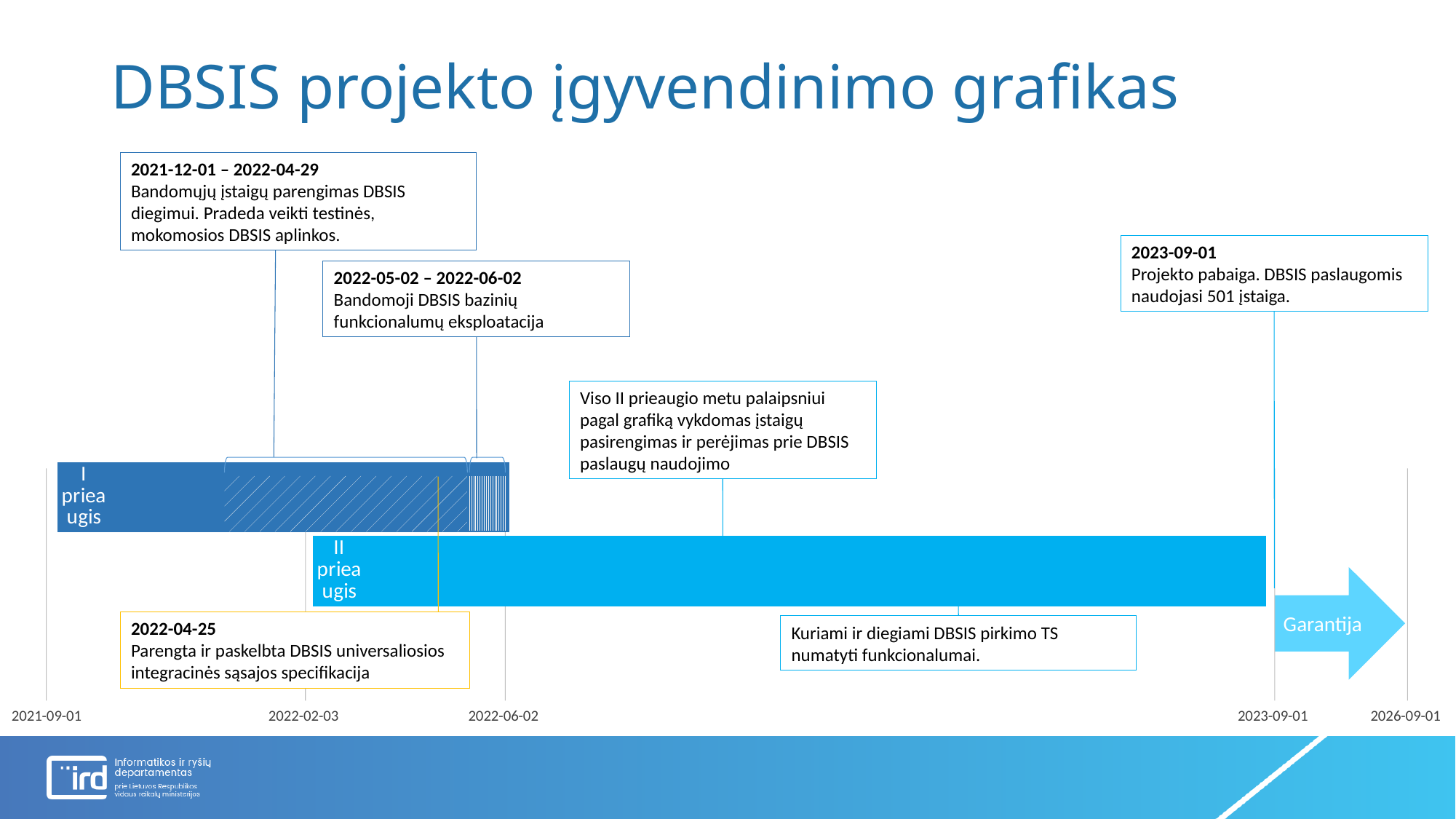
On what date was the DBSIS universal integration interface specification published? 2022-04-25 How many institutions use DBSIS services at the project end according to the annotation? 501 Which phase starts earlier on the timeline, I prieaugis or II prieaugis? I prieaugis What period is given for the pilot exploitation of DBSIS base functionality (Bandomoji DBSIS bazinių funkcionalumų eksploatacija)? 2022-05-02 – 2022-06-02 How many phases (prieaugis bars) are plotted on the timeline? 2 What label is written on the arrow at the right end of the timeline? Garantija What is the earliest date shown on the timeline axis? 2021-09-01 Which phase ends later on the timeline, I prieaugis or II prieaugis? II prieaugis What is the latest date shown on the timeline axis? 2026-09-01 On what date is the project end (Projekto pabaiga) marked? 2023-09-01 How many date labels are shown along the timeline axis? 5 What kind of chart is shown on the slide? Timeline (Gantt chart)